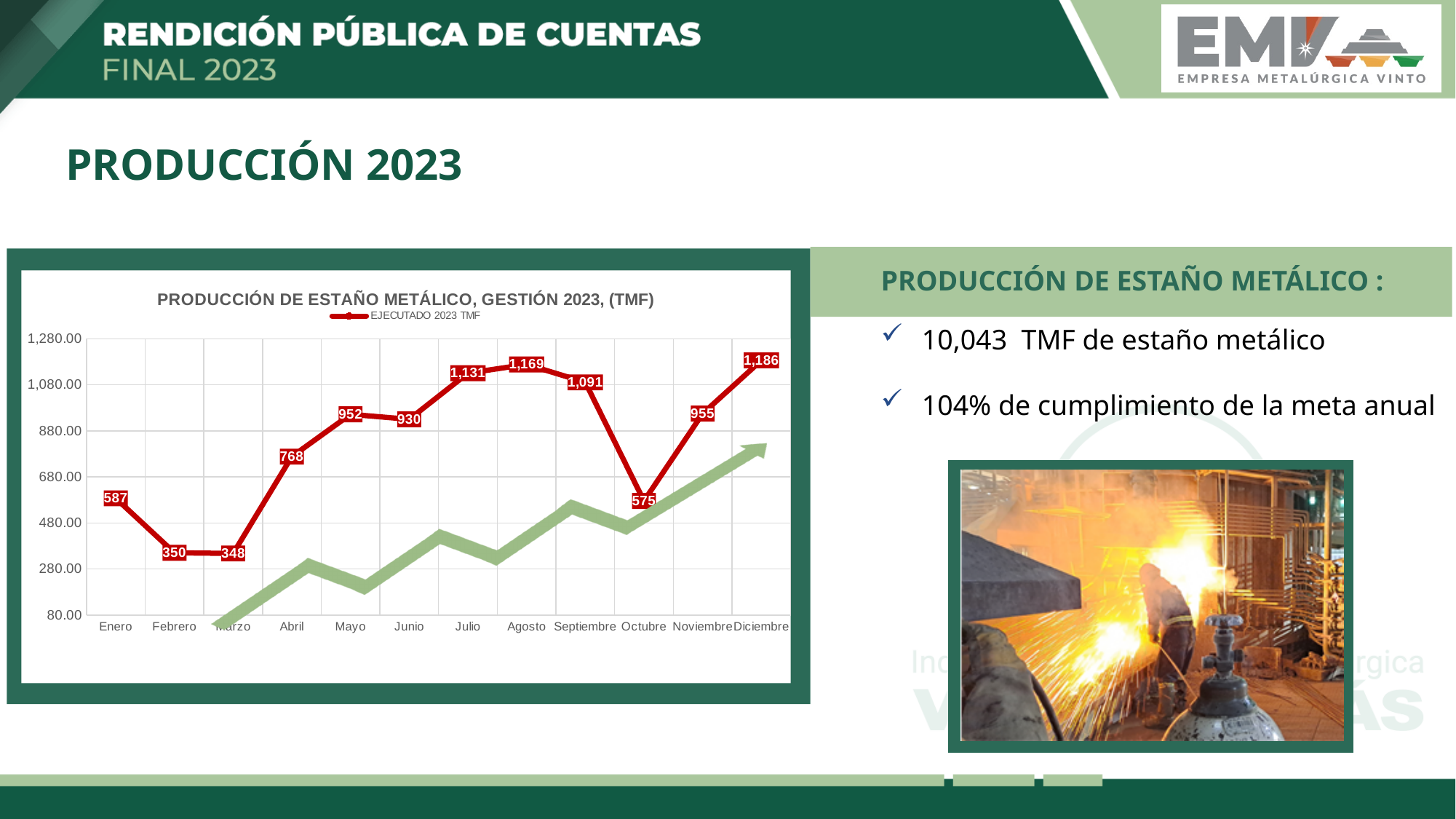
How many series does the legend list? 1 What is the difference between the values for Diciembre and Noviembre? 231 What is the value for Enero? 587 Which month has the lowest value? Marzo What is the value for Octubre? 575 What kind of chart is shown? line chart How many months are plotted on the x axis? 12 Which is larger, the value for Mayo or the value for Junio? Mayo What is the legend entry for the plotted series? EJECUTADO 2023 TMF Which month has the highest value? Diciembre What is the value for Agosto? 1,169 Is the value for Abril greater or less than 680.00? greater